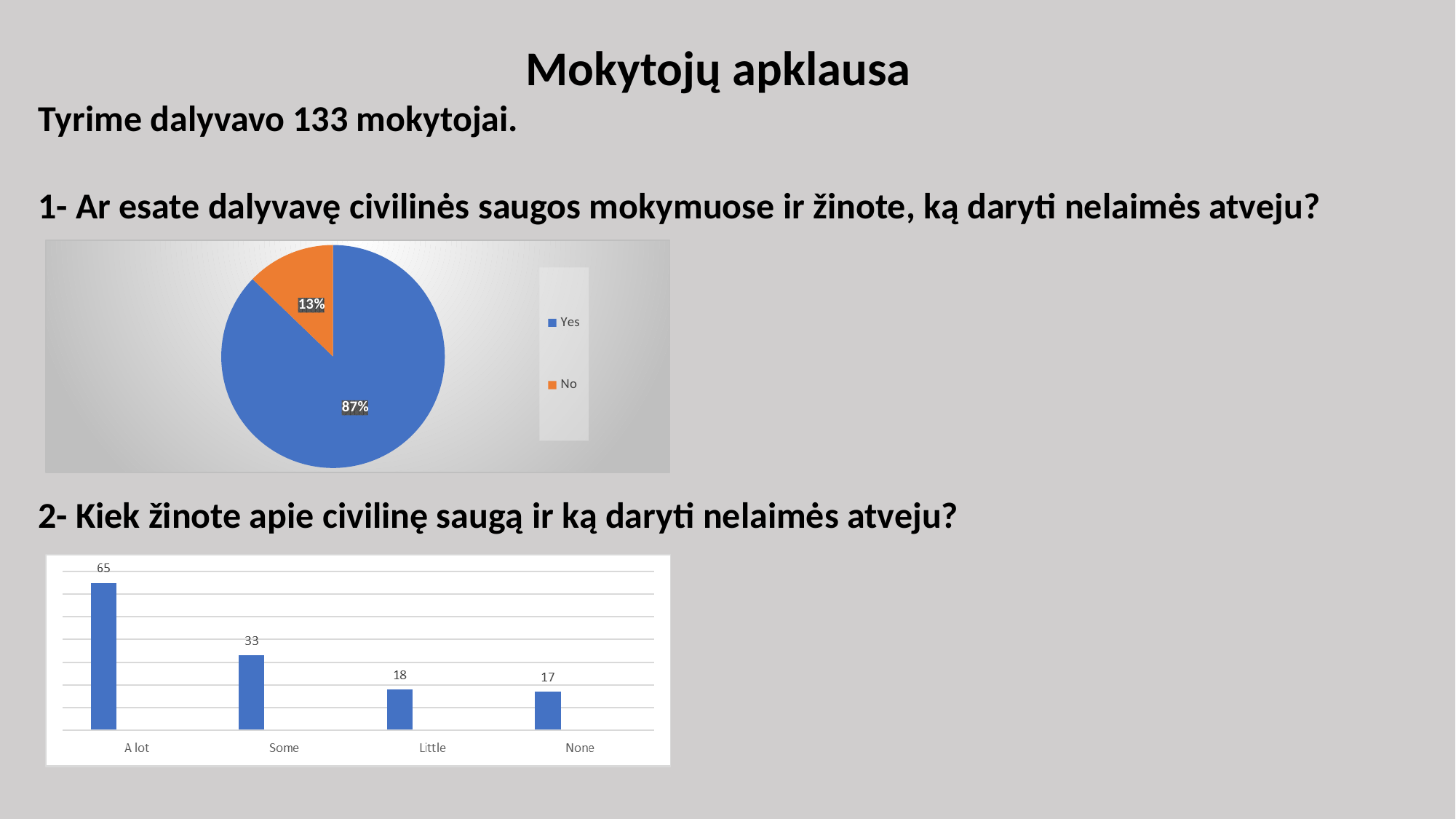
In the bar chart under question 2, which category has the highest value? A lot In the pie chart under question 1, what share of respondents answered Yes? 87% In the pie chart under question 1, what colour is the Yes slice? Blue In the bar chart under question 2, what is the value for Some? 33 In the pie chart under question 1, which answer has the larger slice, Yes or No? Yes In the pie chart under question 1, what share of respondents answered No? 13% In the bar chart under question 2, what is the difference between the values for A lot and Some? 32 In the pie chart under question 1, how many entries does the legend list? 2 In the bar chart under question 2, how many categories are shown on the x axis? 4 What kind of chart is shown under question 1? Pie chart In the bar chart under question 2, what is the value for A lot? 65 In the bar chart under question 2, which category has the lowest value? None